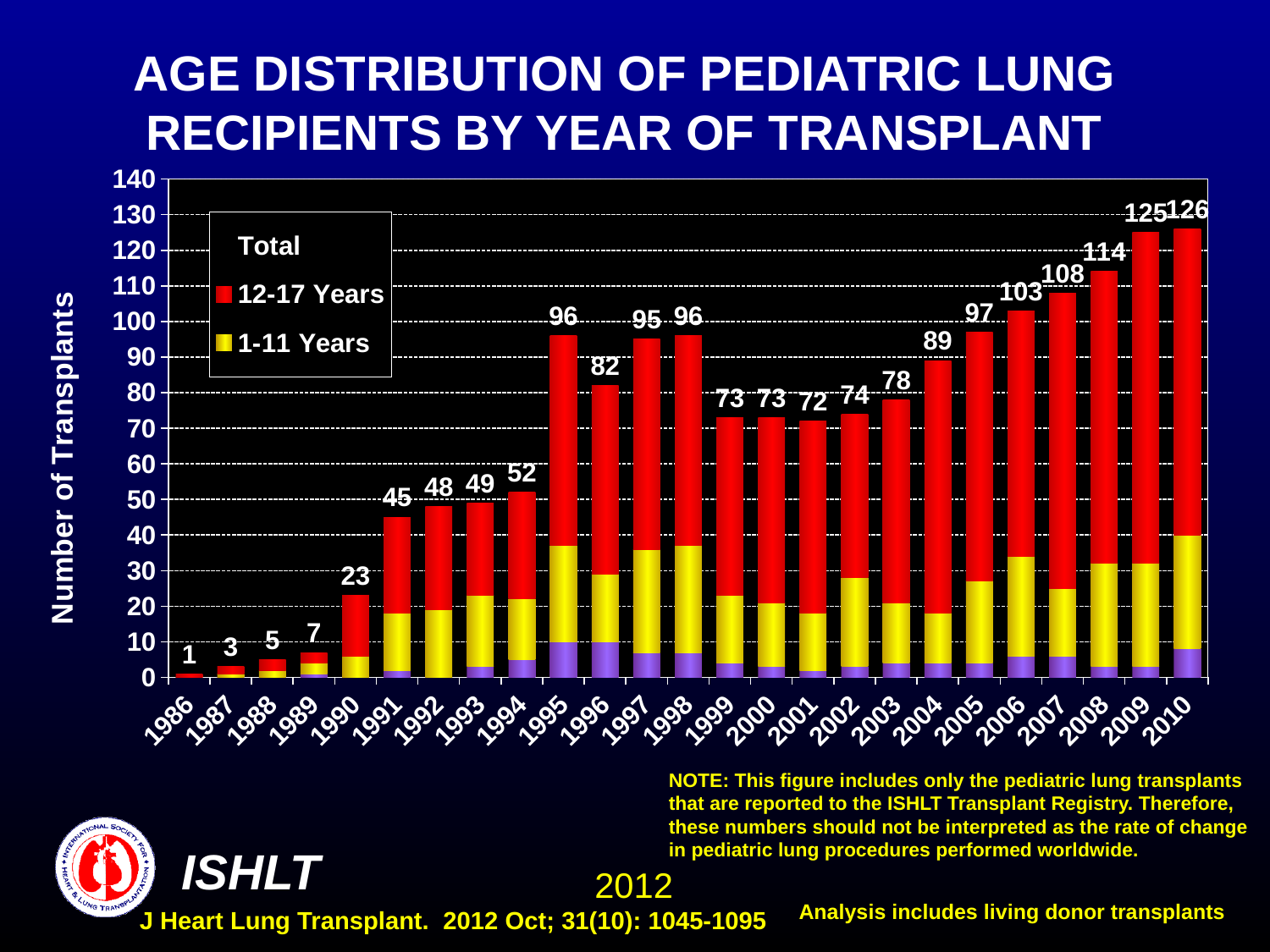
What is the difference between the total for 2009 and the total for 2004? 36 How many age-group series does the legend list? 2 How many years are shown on the x axis? 25 What is the total number of transplants shown for 1995? 96 Do the total numbers of transplants rise or fall from 2001 to 2010? Rise What kind of chart is shown on the slide? Stacked bar chart What is the label of the y axis? Number of Transplants Which year has the highest total number of transplants? 2010 Which year has the lowest total number of transplants? 1986 Which year has a larger total, 1996 or 2003? 1996 What is the total number of transplants shown for 1990? 23 What is the total number of pediatric lung transplants shown for 2010? 126